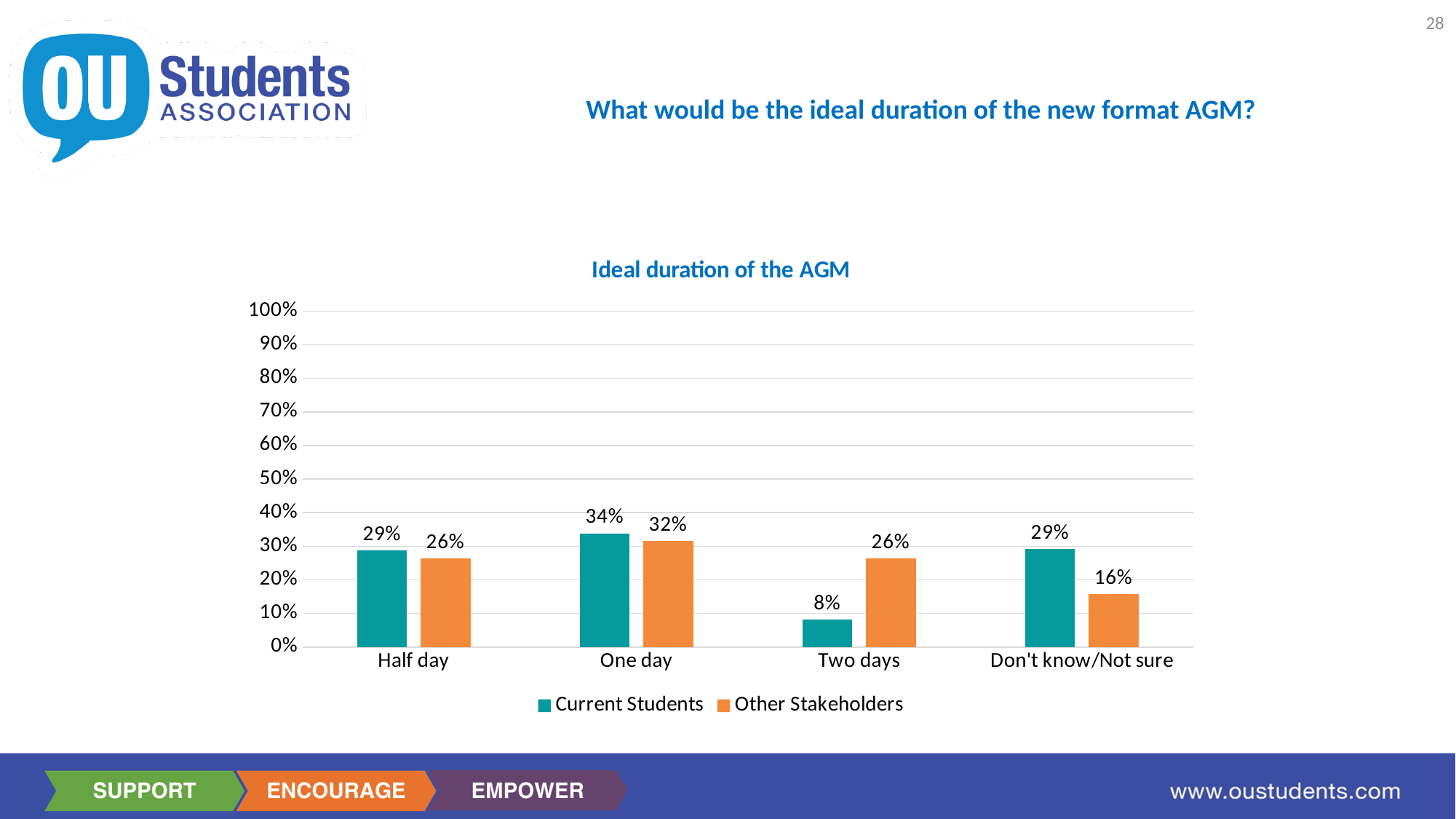
What is the difference between Current Students and Other Stakeholders for Two days? 18% What kind of chart is shown? bar chart Which category has the highest value for Current Students? One day For Half day, which series has the larger value, Current Students or Other Stakeholders? Current Students How many series does the legend list? 2 Is the value for Current Students for Two days greater or less than 10%? less Which category has the lowest value for Other Stakeholders? Don't know/Not sure What is the value for Current Students for One day? 34% What is the value for Other Stakeholders for Two days? 26% How many categories are shown on the x axis? 4 What is the title of the chart? Ideal duration of the AGM What is the value for Other Stakeholders for Don't know/Not sure? 16%